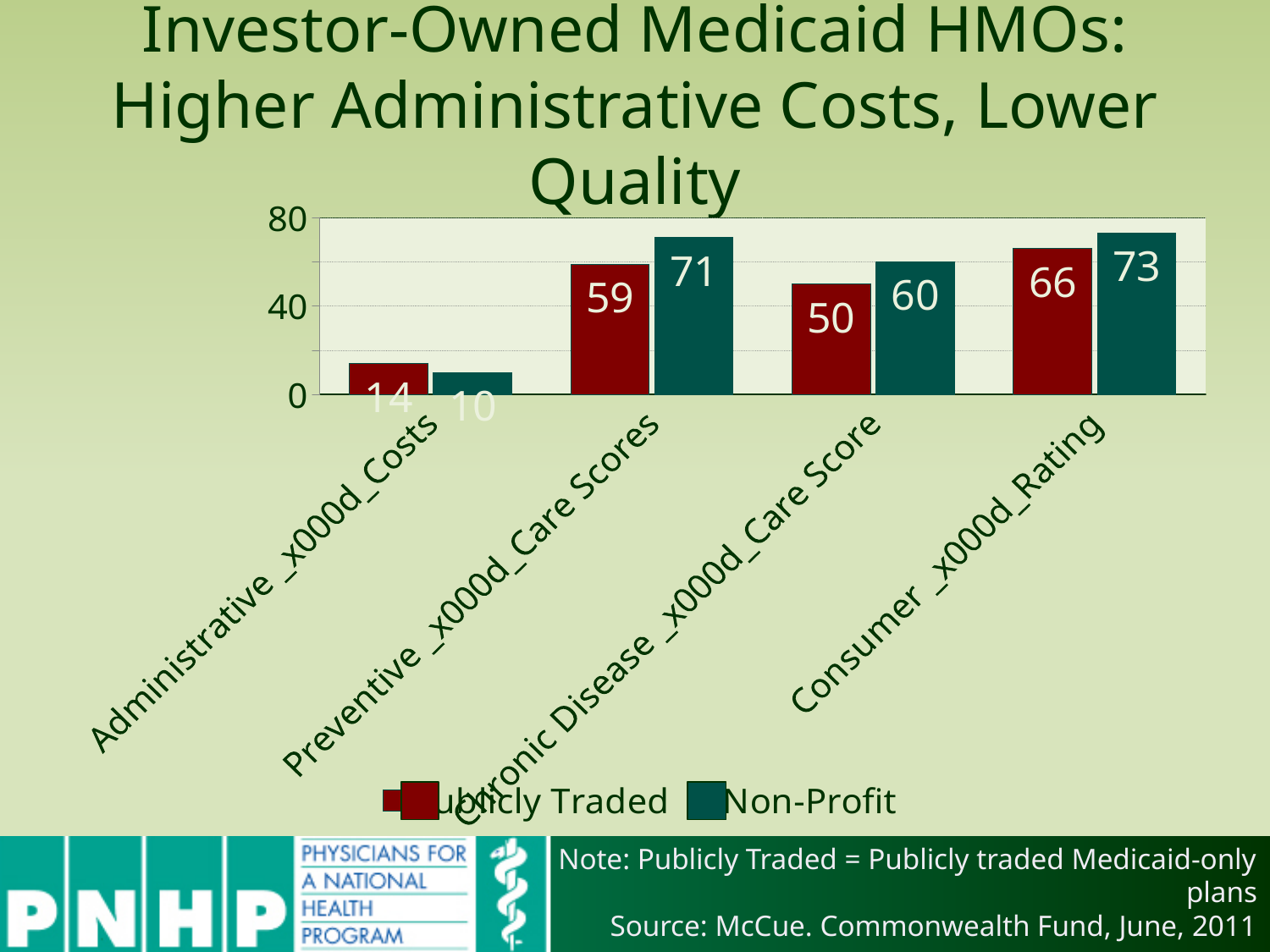
How many categories are shown on the x axis? 4 What is the Non-Profit value for Consumer Rating? 73 What is the Non-Profit value for Preventive Care Scores? 71 Which series is shown in dark red? Publicly Traded For Administrative Costs, which is larger: the Publicly Traded value or the Non-Profit value? Publicly Traded Which category has the lowest Publicly Traded value? Administrative Costs What is the Publicly Traded value for Chronic Disease Care Score? 50 What kind of chart is shown on the slide? Bar chart Which category has the highest Non-Profit value? Consumer Rating How many series does the legend list? 2 What is the difference between the Non-Profit and Publicly Traded values for Preventive Care Scores? 12 What is the Publicly Traded value for Administrative Costs? 14